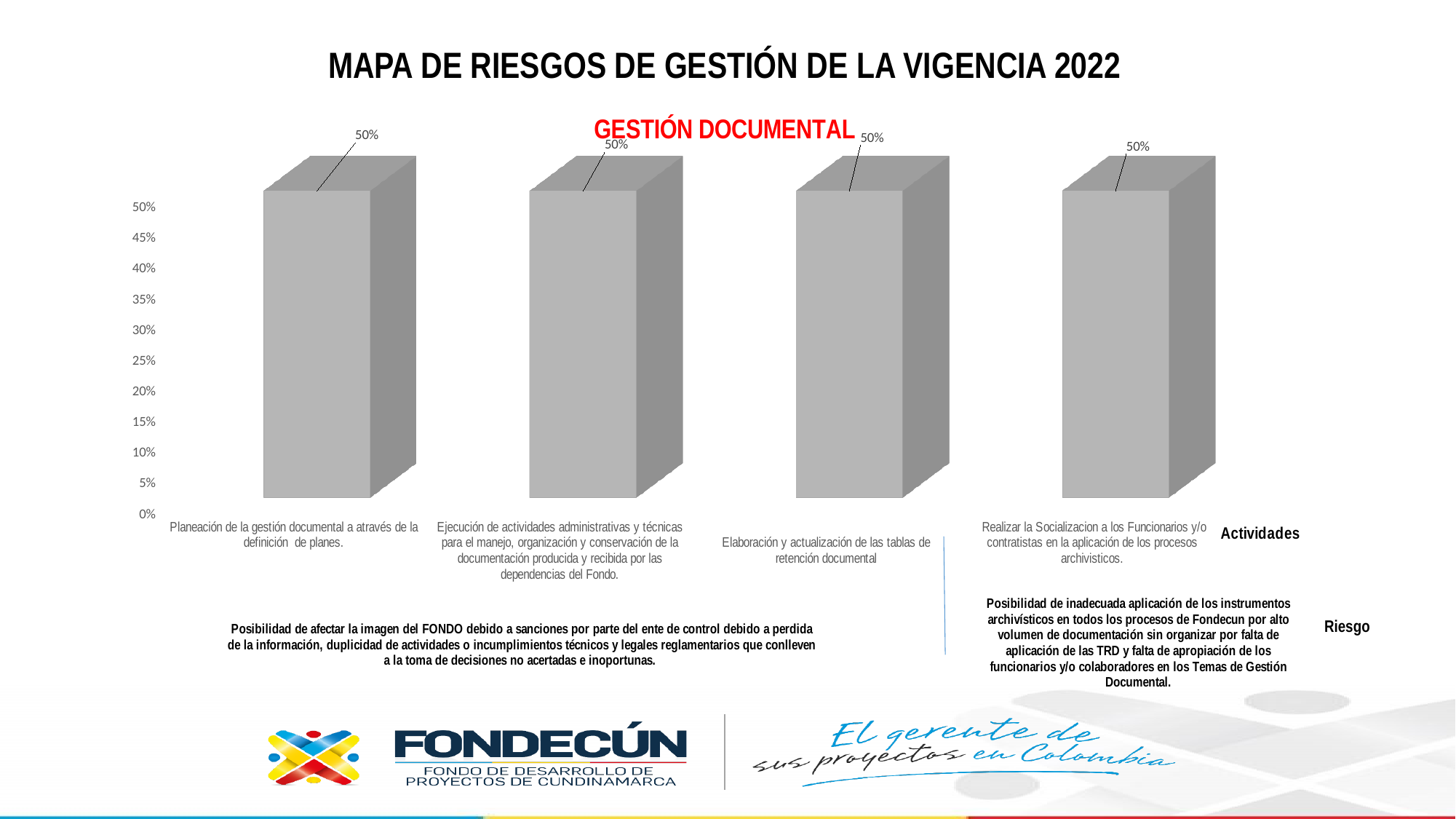
Do the values rise, fall, or stay the same across the activities from left to right? Stay the same What is the value for 'Realizar la Socializacion a los Funcionarios y/o contratistas en la aplicación de los procesos archivisticos'? 50% What is the highest tick value shown on the vertical axis? 50% What is the value for 'Ejecución de actividades administrativas y técnicas para el manejo, organización y conservación de la documentación producida y recibida por las dependencias del Fondo'? 50% How many bars (activities) are plotted in the chart? 4 What kind of chart is shown on the slide? Bar chart What is the value for 'Planeación de la gestión documental a través de la definición de planes'? 50% Is the value for 'Elaboración y actualización de las tablas de retención documental' greater or less than 40%? greater What is the title shown in red above the chart? GESTIÓN DOCUMENTAL What is the difference between the value for 'Planeación de la gestión documental a través de la definición de planes' and the value for 'Elaboración y actualización de las tablas de retención documental'? 0% What is the value for 'Elaboración y actualización de las tablas de retención documental'? 50% Is the value for 'Planeación de la gestión documental a través de la definición de planes' greater or less than 25%? greater